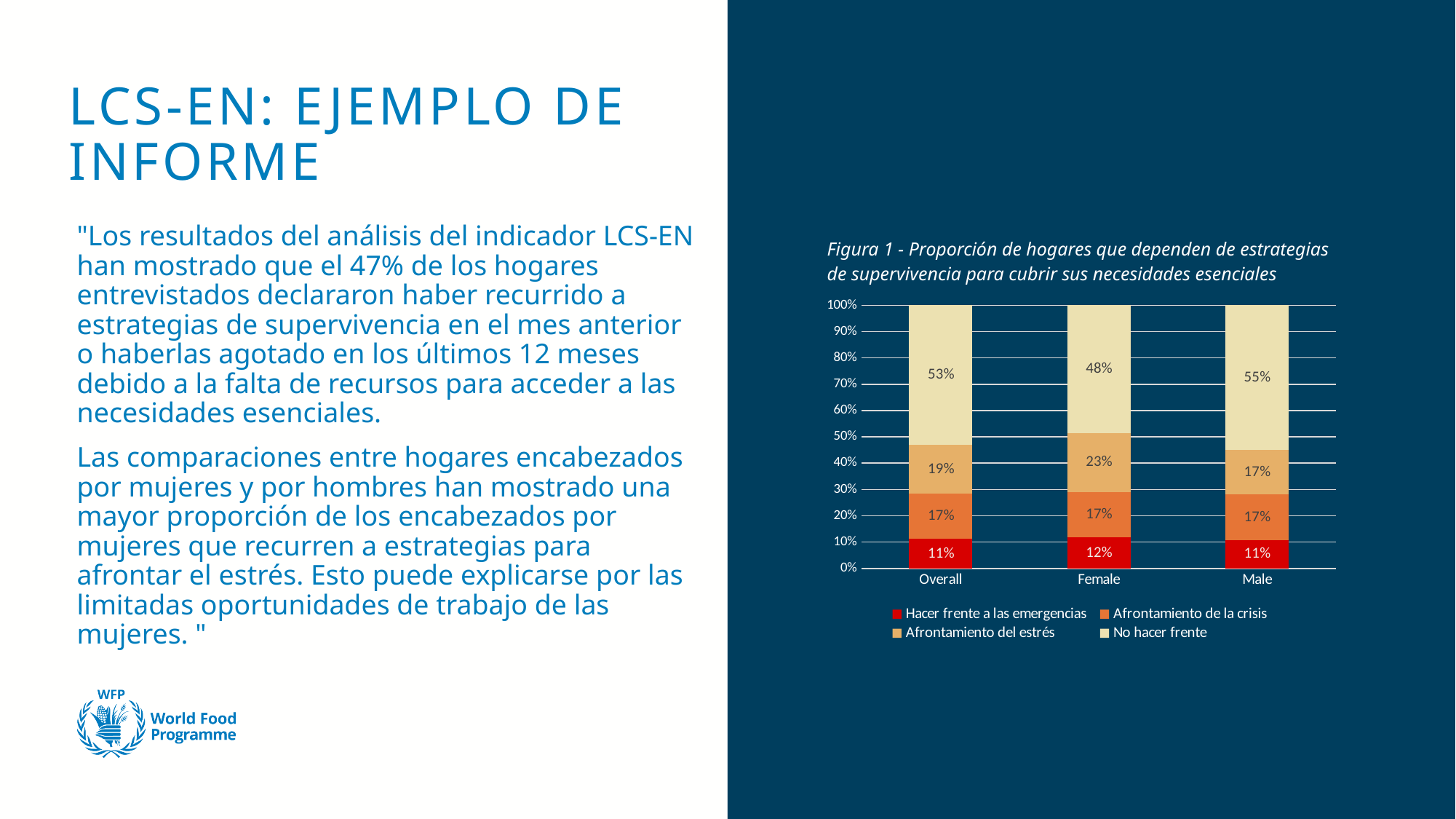
What type of chart is shown on the slide? Stacked bar chart What is the difference between the 'Afrontamiento del estrés' values for Female and Male? 6% Which legend entry is shown in red? Hacer frente a las emergencias What is the combined value of 'Hacer frente a las emergencias' and 'Afrontamiento de la crisis' for Female? 29% What is the value of 'No hacer frente' for Female? 48% Which category has the highest value for 'No hacer frente'? Male How many categories are shown on the x axis of the chart? 3 What is the value of 'Hacer frente a las emergencias' for Overall? 11% What is the value of 'Afrontamiento del estrés' for Male? 17% Which category has the lowest value for 'Afrontamiento del estrés'? Male Which is larger: the 'No hacer frente' value for Overall or for Female? Overall How many series does the chart legend list? 4